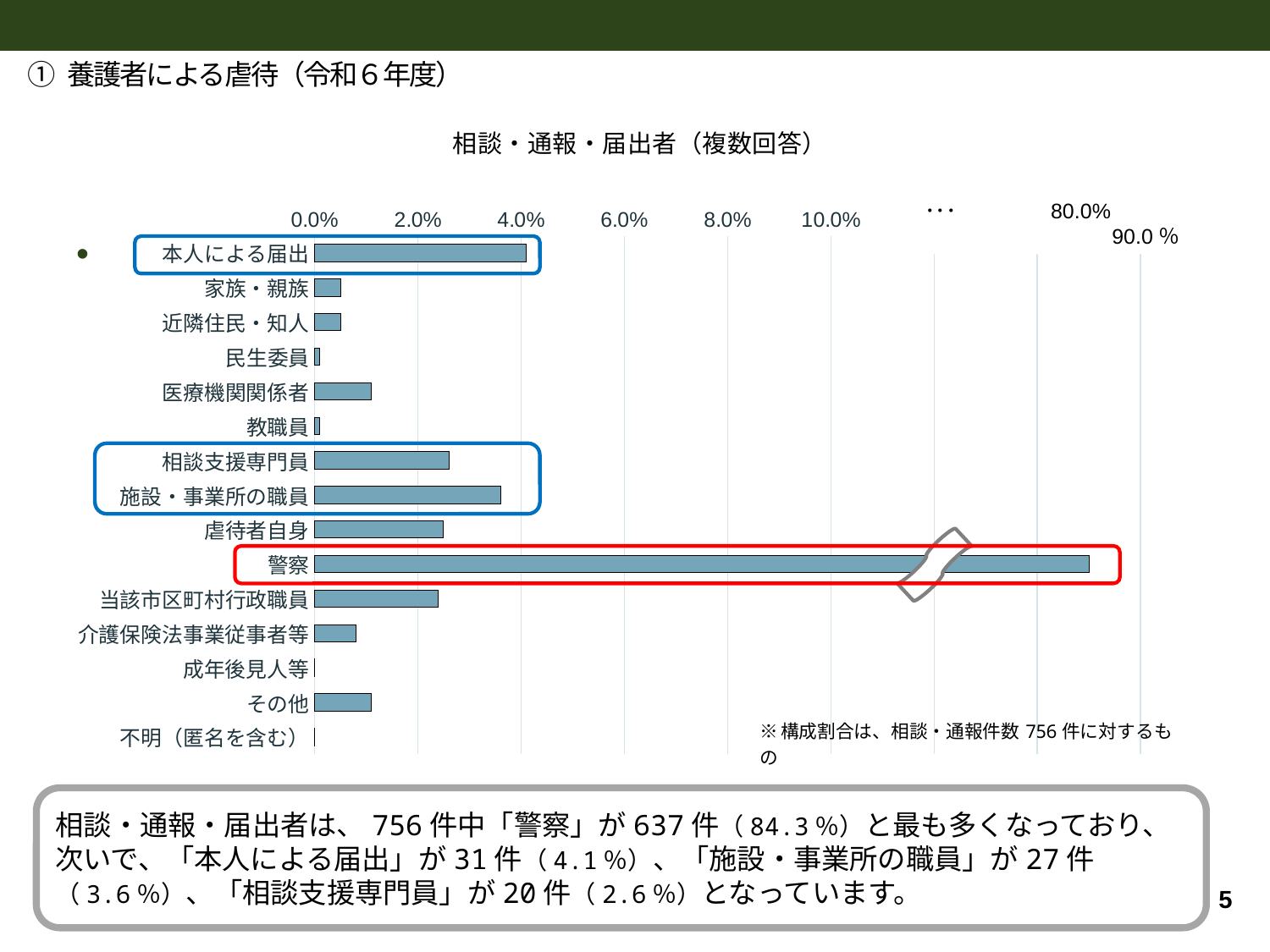
What is the value for 本人による届出? 4.1% Is the value for 家族・親族 greater or less than 2.0%? less Which category has the highest value in the chart? 警察 How many categories are plotted in the chart? 15 What is the title of the chart? 相談・通報・届出者（複数回答） Is the value for 虐待者自身 greater or less than 2.0%? greater What is the value for 相談支援専門員? 2.6% What is the difference between the value for 警察 and the value for 本人による届出? 80.2 percentage points What is the value for 警察? 84.3% What is the value for 施設・事業所の職員? 3.6% Which is larger, the value for 本人による届出 or the value for 施設・事業所の職員? 本人による届出 What kind of chart is shown on the slide? bar chart